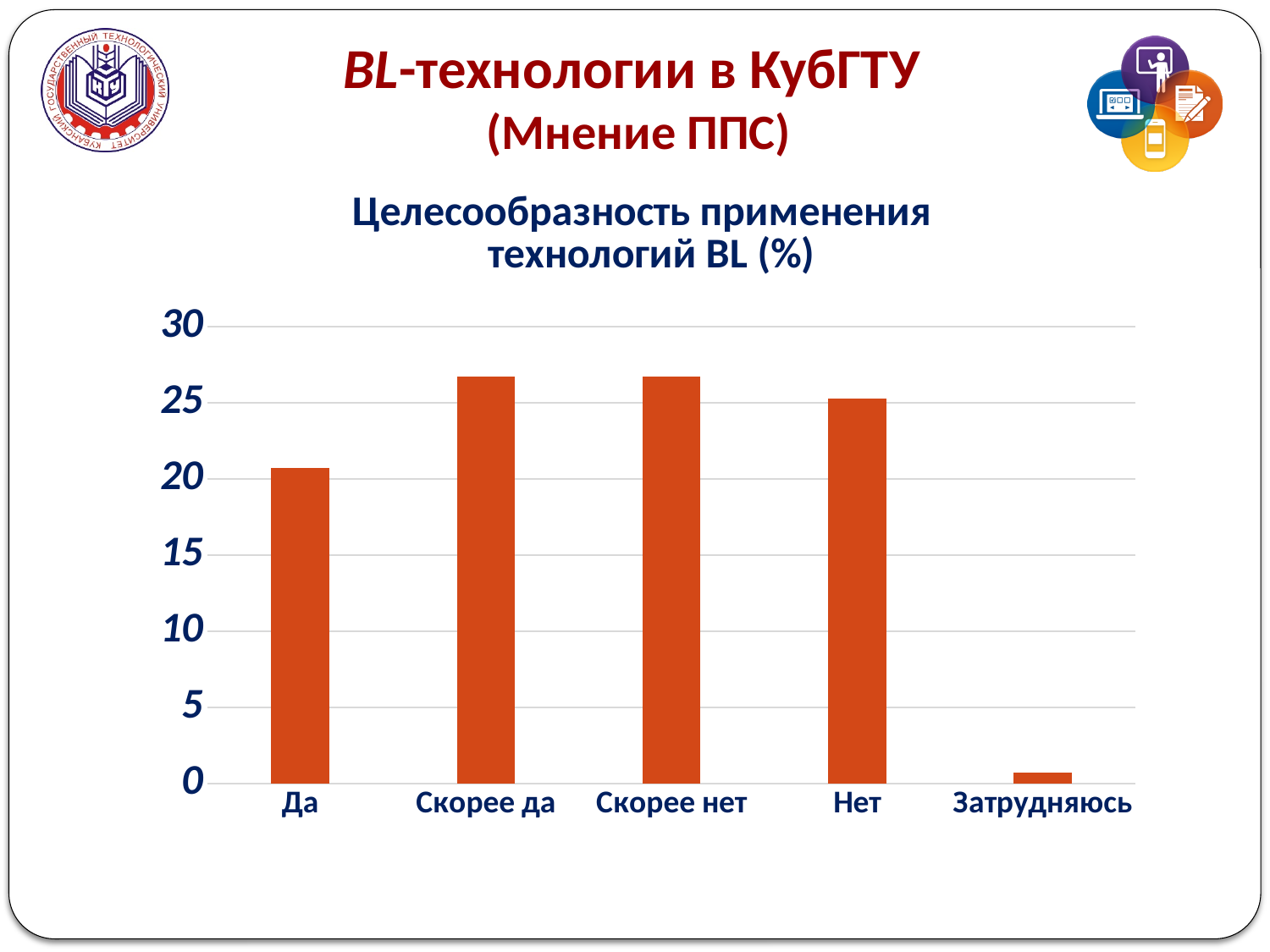
Is the value for Затрудняюсь greater or less than 5? less Is the value for Скорее да greater or less than 25? greater What is the title of the chart? Целесообразность применения технологий BL (%) How many categories are shown on the x axis of the chart? 5 Which is larger, the value for Да or the value for Нет? Нет Is the value for Да greater or less than 20? greater Which is larger, the value for Затрудняюсь or the value for Да? Да What kind of chart is shown on the slide? bar chart Which category has the lowest value in the chart? Затрудняюсь